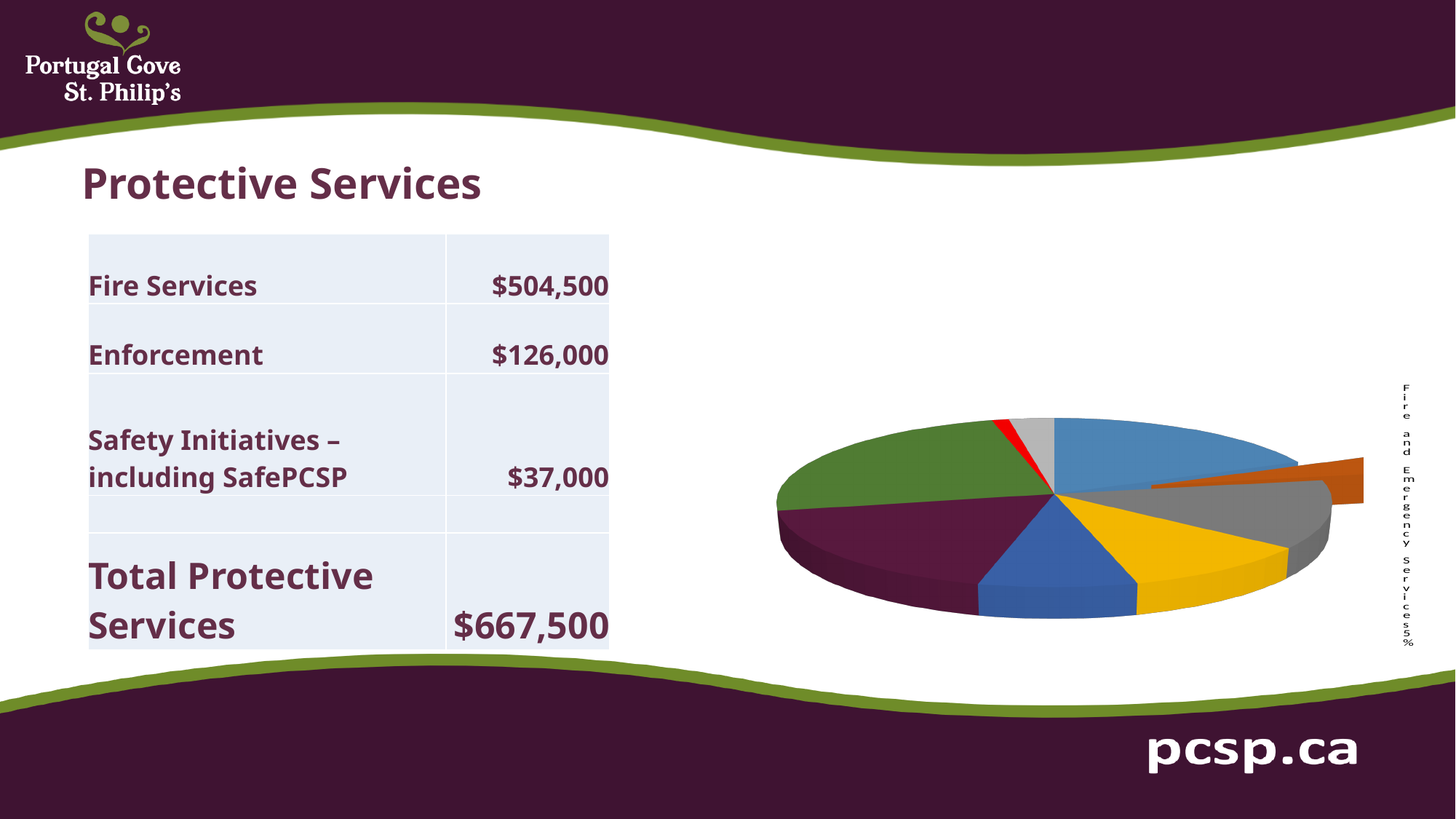
What colour is the slice that is pulled out (exploded) from the pie chart? orange What share of the pie does Fire and Emergency Services represent? 5% Is the share for Fire and Emergency Services greater or less than 10%? less What kind of chart is shown on the right side of the slide? pie chart Which slice is the only one labelled on the pie chart? Fire and Emergency Services Which slice of the pie chart is the smallest? the red slice How many slices does the pie chart contain? 9